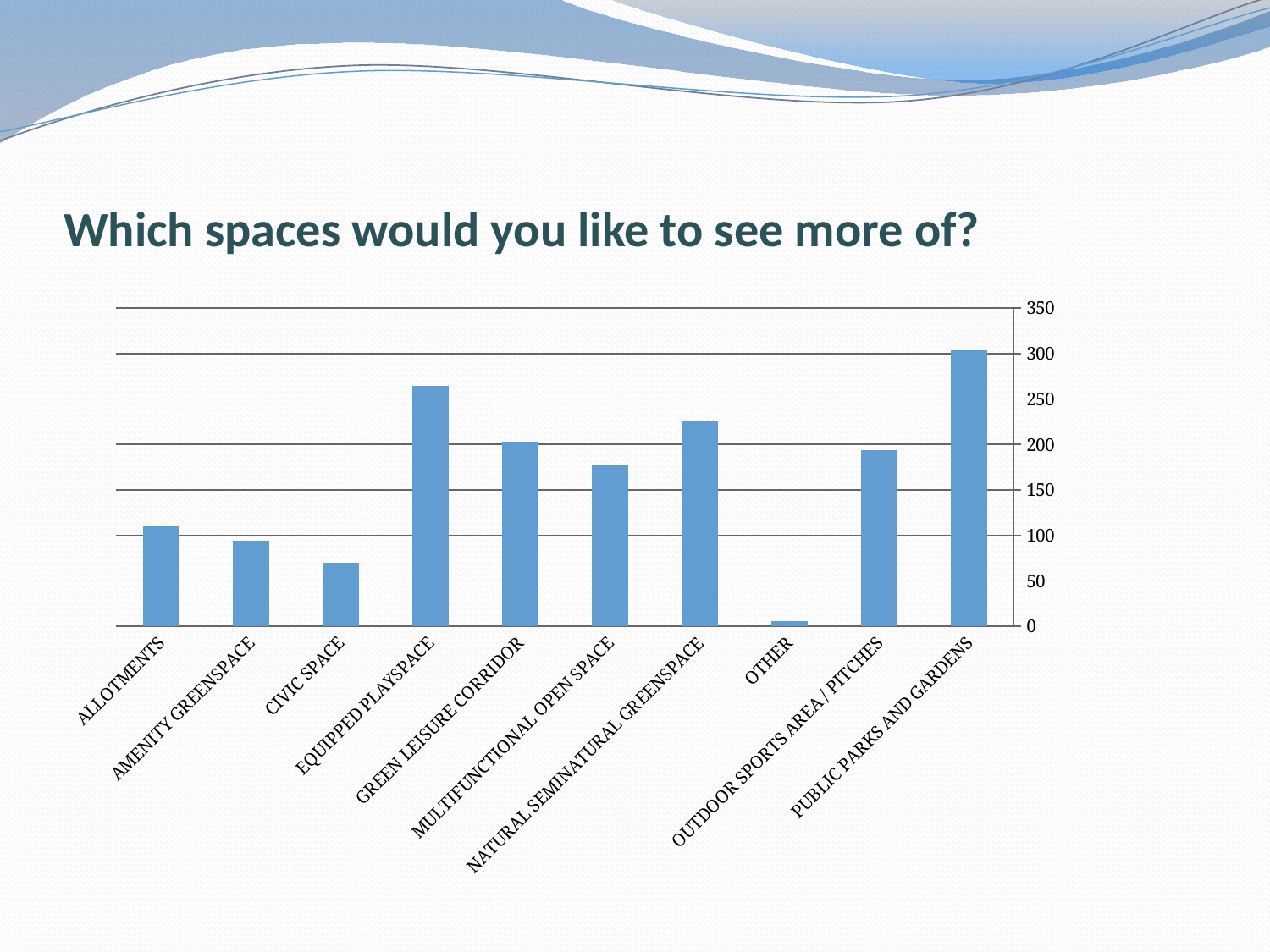
Is the value for OTHER greater or less than 50? less How many categories are shown on the x axis of the chart? 10 Which category has the highest value in the chart? PUBLIC PARKS AND GARDENS Is the value for NATURAL SEMINATURAL GREENSPACE greater or less than 200? greater Is the value for EQUIPPED PLAYSPACE greater or less than 250? greater Which is larger, the value for ALLOTMENTS or the value for AMENITY GREENSPACE? ALLOTMENTS Which is larger, the value for GREEN LEISURE CORRIDOR or the value for MULTIFUNCTIONAL OPEN SPACE? GREEN LEISURE CORRIDOR Which category has the lowest value in the chart? OTHER What kind of chart is shown on the slide? bar chart What is the title of the slide containing the chart? Which spaces would you like to see more of?